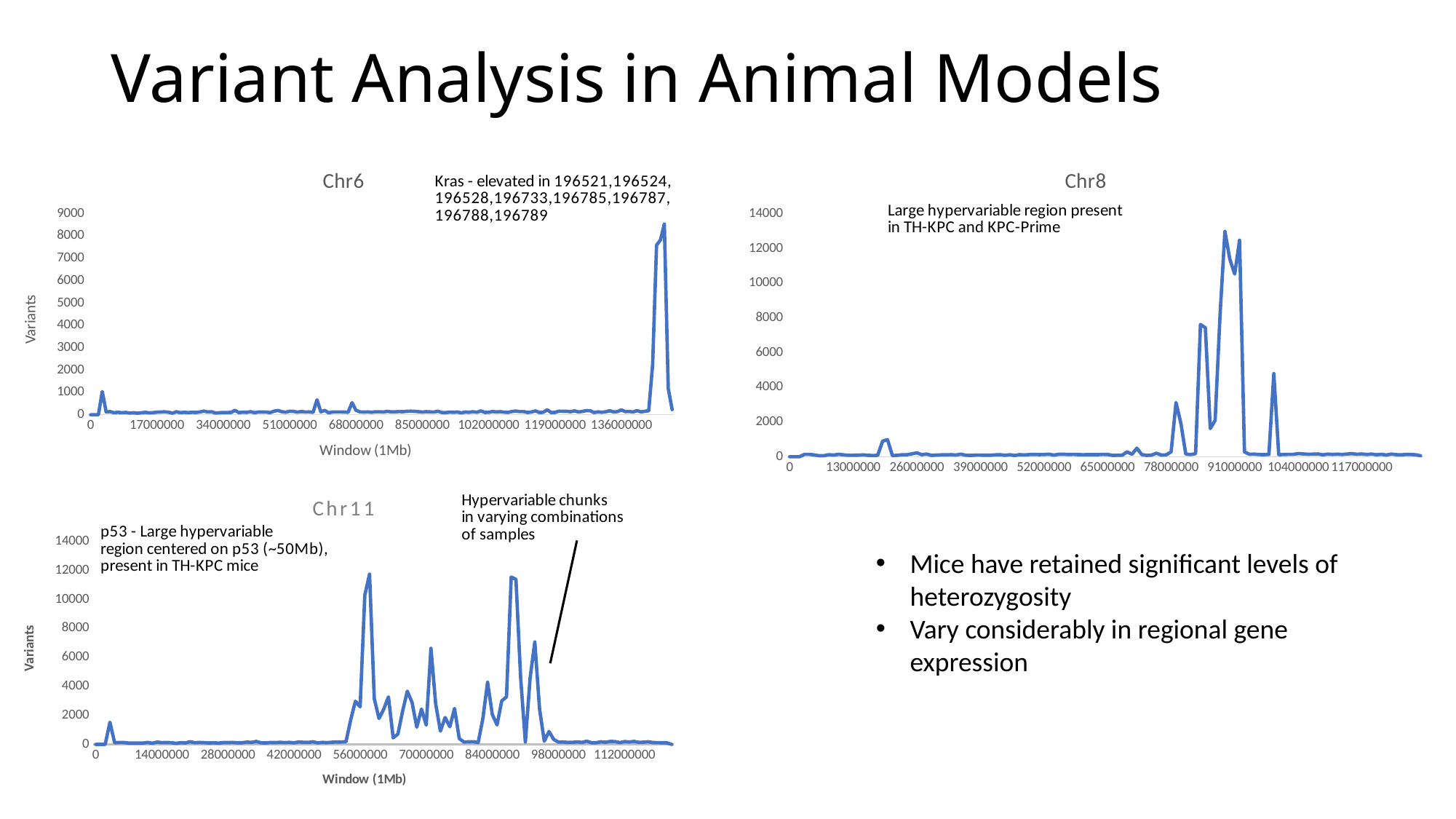
What is the highest tick shown on the y-axis of the Chr6 chart? 9000 In the Chr11 chart, is the highest value of the line greater or less than 10000? greater What is the x-axis title of the Chr6 chart? Window (1Mb) What kind of chart is the Chr6 chart? line chart In the Chr8 chart, is the small bump near window 20000000 greater or less than 2000? less How many charts are shown on the slide? 3 In the Chr6 chart, is the value at window 85000000 greater or less than 1000? less Which chart has the higher peak value, Chr6 or Chr8? Chr8